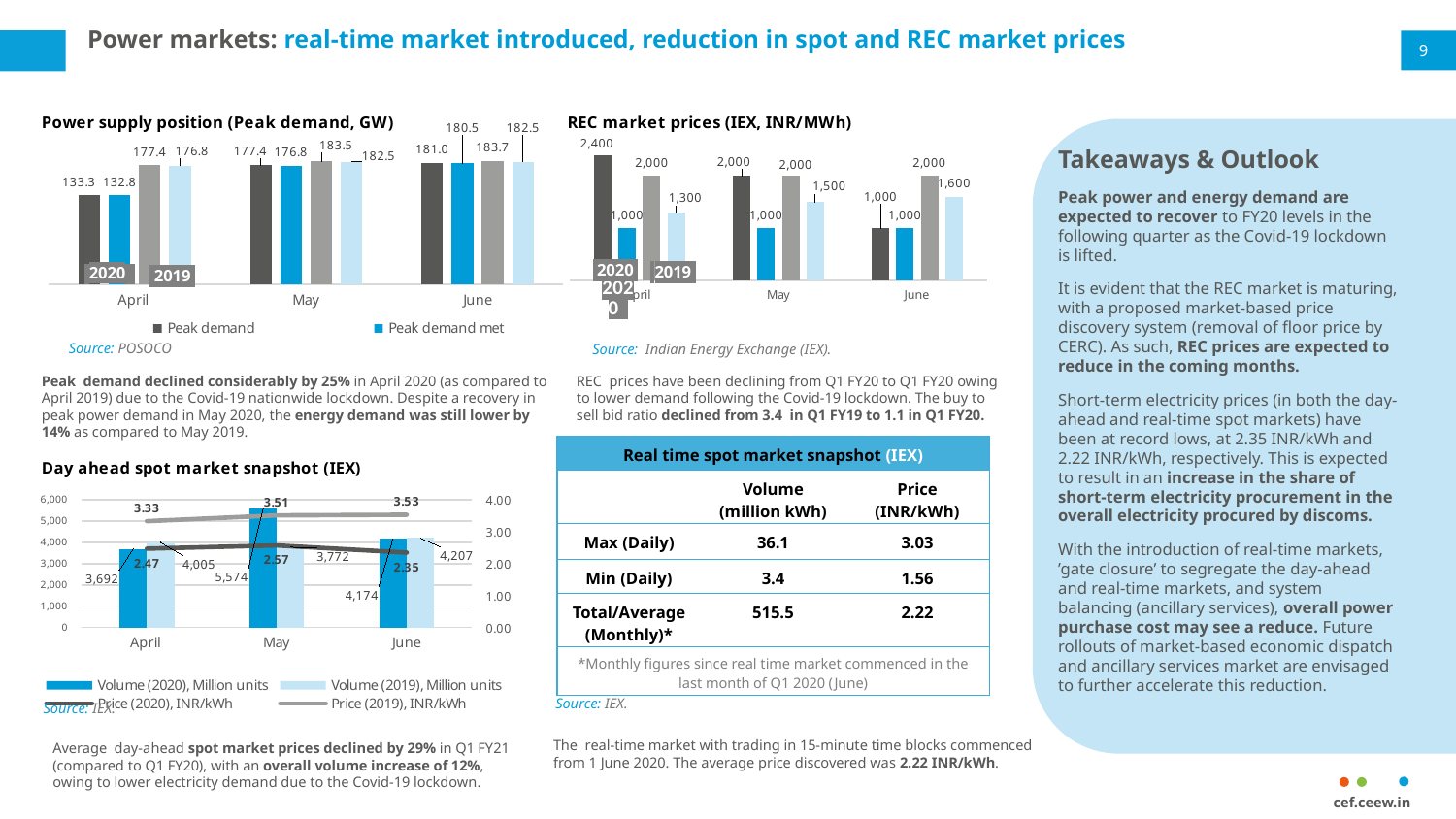
In the 'Power supply position (Peak demand, GW)' chart, how many months are shown on the x axis? 3 In the 'Day ahead spot market snapshot (IEX)' chart, in which month is Volume (2020) highest? May In the 'Day ahead spot market snapshot (IEX)' chart, how many series does the legend list? 4 What kind of chart is 'REC market prices (IEX, INR/MWh)'? Bar chart In the 'Power supply position (Peak demand, GW)' chart, what is the 2020 peak demand value for April? 133.3 In the 'Day ahead spot market snapshot (IEX)' chart, what is the Price (2020) for June? 2.35 In the 'Power supply position (Peak demand, GW)' chart, how many series does the legend list? 2 In the 'REC market prices (IEX, INR/MWh)' chart, is the first (dark grey) bar for April larger or smaller than the first (dark grey) bar for May? Larger In the 'Power supply position (Peak demand, GW)' chart, what is the 2020 peak demand met value for April? 132.8 In the 'REC market prices (IEX, INR/MWh)' chart, what is the highest value shown? 2,400 In the 'Day ahead spot market snapshot (IEX)' chart, what is the Volume (2020) for May? 5,574 In the 'Power supply position (Peak demand, GW)' chart, what is the difference between the 2019 peak demand (177.4) and the 2020 peak demand (133.3) for April? 44.1